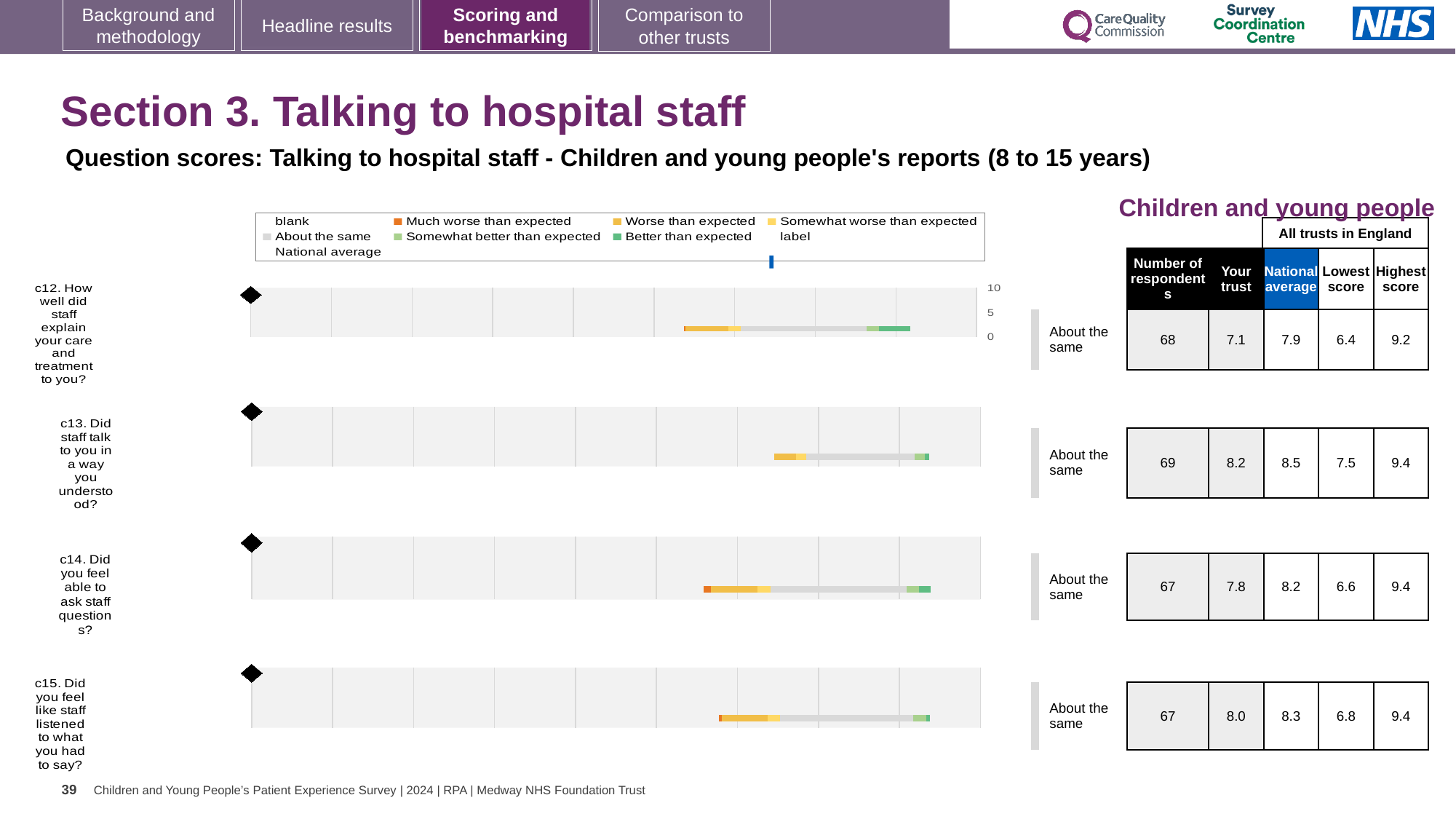
How many respondents answered c14 (Did you feel able to ask staff questions?)? 67 What is the national average for c13 (Did staff talk to you in a way you understood?)? 8.5 What is the highest score among all trusts in England for c15 (Did you feel like staff listened to what you had to say?)? 9.4 Which has the larger 'Your trust' score, c13 or c15? c13 What is the lowest score among all trusts in England for c12? 6.4 How many survey questions are plotted on the slide? 4 What kind of chart is used for each question on the slide? bar chart What is the 'Your trust' score for c12 (How well did staff explain your care and treatment to you?)? 7.1 Which question has the highest 'Your trust' score? c13 What benchmark category is shown for c14 (Did you feel able to ask staff questions?)? About the same What is the difference between the national average and the 'Your trust' score for c12? 0.8 Which question has the lowest 'Your trust' score? c12